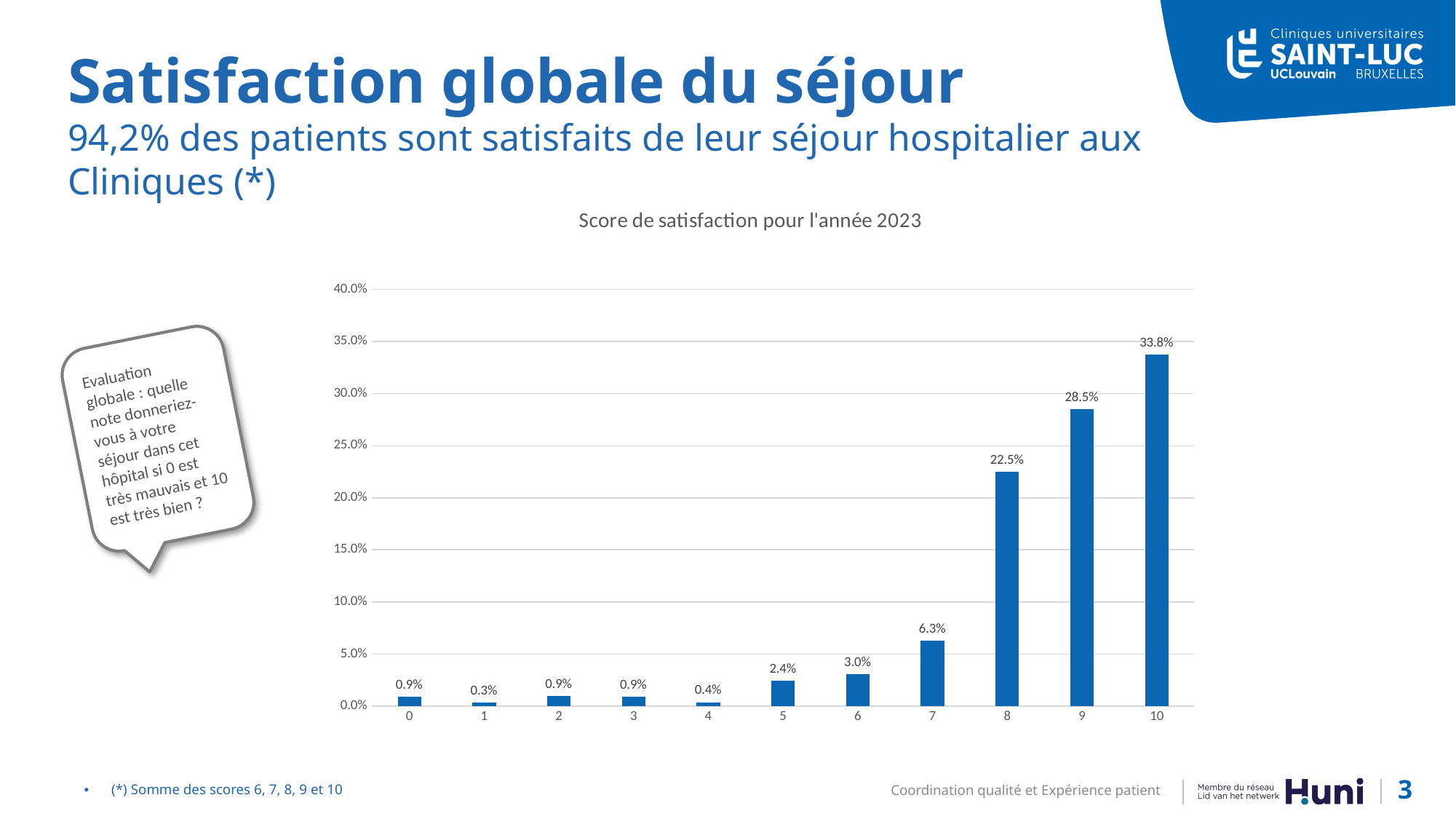
Which is larger, the value for score 5 or the value for score 6? score 6 What is the value for score 1? 0.3% Which score has the lowest value? 1 How many score categories are shown on the x axis? 11 What is the title of the chart? Score de satisfaction pour l'année 2023 What is the difference between the values for score 10 and score 9? 5.3% What kind of chart is shown? bar chart What is the value for score 10? 33.8% Which score has the highest value? 10 Is the value for score 8 greater or less than 20.0%? greater What is the difference between the values for score 8 and score 7? 16.2% What is the value for score 7? 6.3%